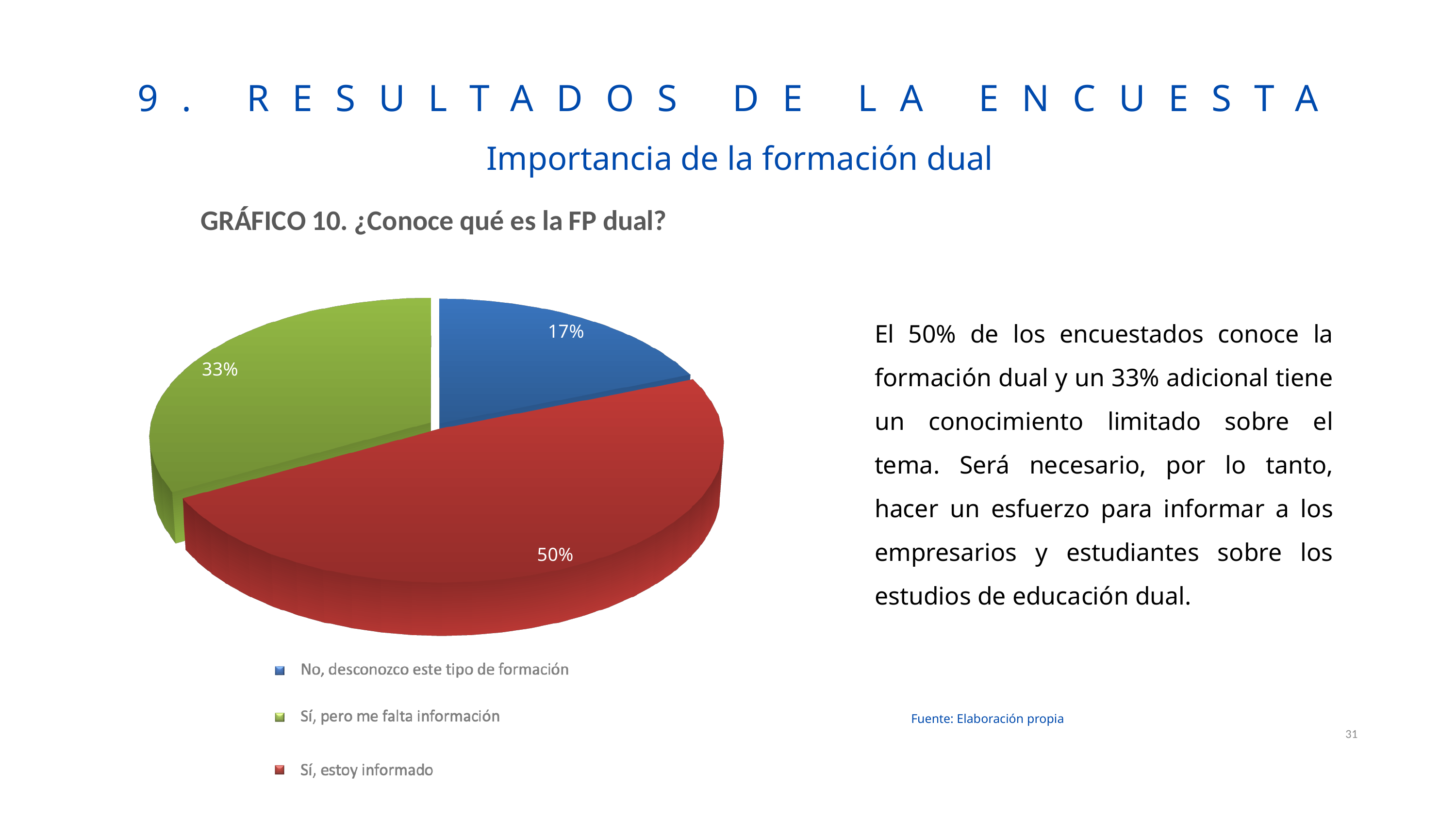
What share of respondents answered "No, desconozco este tipo de formación"? 17% What kind of chart is shown on the slide? pie chart What colour is the slice for "Sí, estoy informado"? red Which response has the smallest slice of the pie? No, desconozco este tipo de formación What share of respondents answered "Sí, pero me falta información"? 33% What is the difference in percentage points between "Sí, pero me falta información" and "No, desconozco este tipo de formación"? 16 percentage points What share of respondents answered "Sí, estoy informado"? 50% Which is larger: the slice for "Sí, pero me falta información" or the slice for "No, desconozco este tipo de formación"? Sí, pero me falta información How many slices does the pie chart have? 3 Which response has the largest slice of the pie? Sí, estoy informado What is the title of the chart? GRÁFICO 10. ¿Conoce qué es la FP dual? What is the difference in percentage points between "Sí, estoy informado" and "No, desconozco este tipo de formación"? 33 percentage points